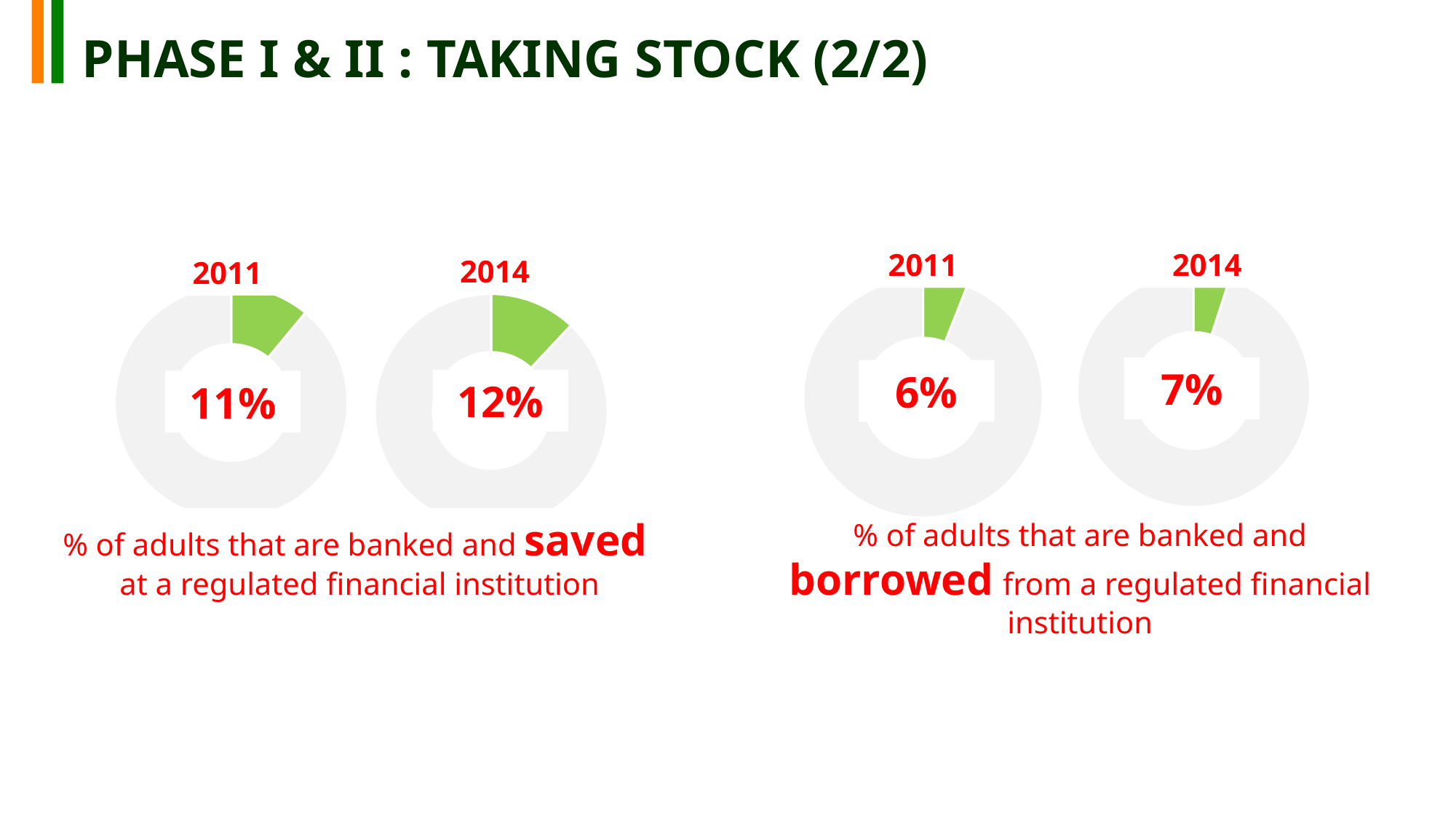
In the 'borrowed from a regulated financial institution' charts, what is the value for 2011? 6% In the 'borrowed from a regulated financial institution' charts, what is the value for 2014? 7% In the 'borrowed from a regulated financial institution' charts, by how many percentage points did the value change from 2011 to 2014? 1 percentage point In the 'saved at a regulated financial institution' charts, by how many percentage points did the value change from 2011 to 2014? 1 percentage point Which is larger: the 2014 value for adults who saved at a regulated financial institution, or the 2014 value for adults who borrowed from a regulated financial institution? Saved (12%) How many donut charts are shown on the slide? 4 In the 'saved at a regulated financial institution' charts, what is the value for 2011? 11% In the 'saved at a regulated financial institution' charts, what is the value for 2014? 12% What kind of chart is used to show the percentages on this slide? Donut (pie) chart What is the title of the slide? PHASE I & II : TAKING STOCK (2/2) Did the share of banked adults who borrowed from a regulated financial institution rise or fall from 2011 to 2014? Rise Did the share of banked adults who saved at a regulated financial institution rise or fall from 2011 to 2014? Rise